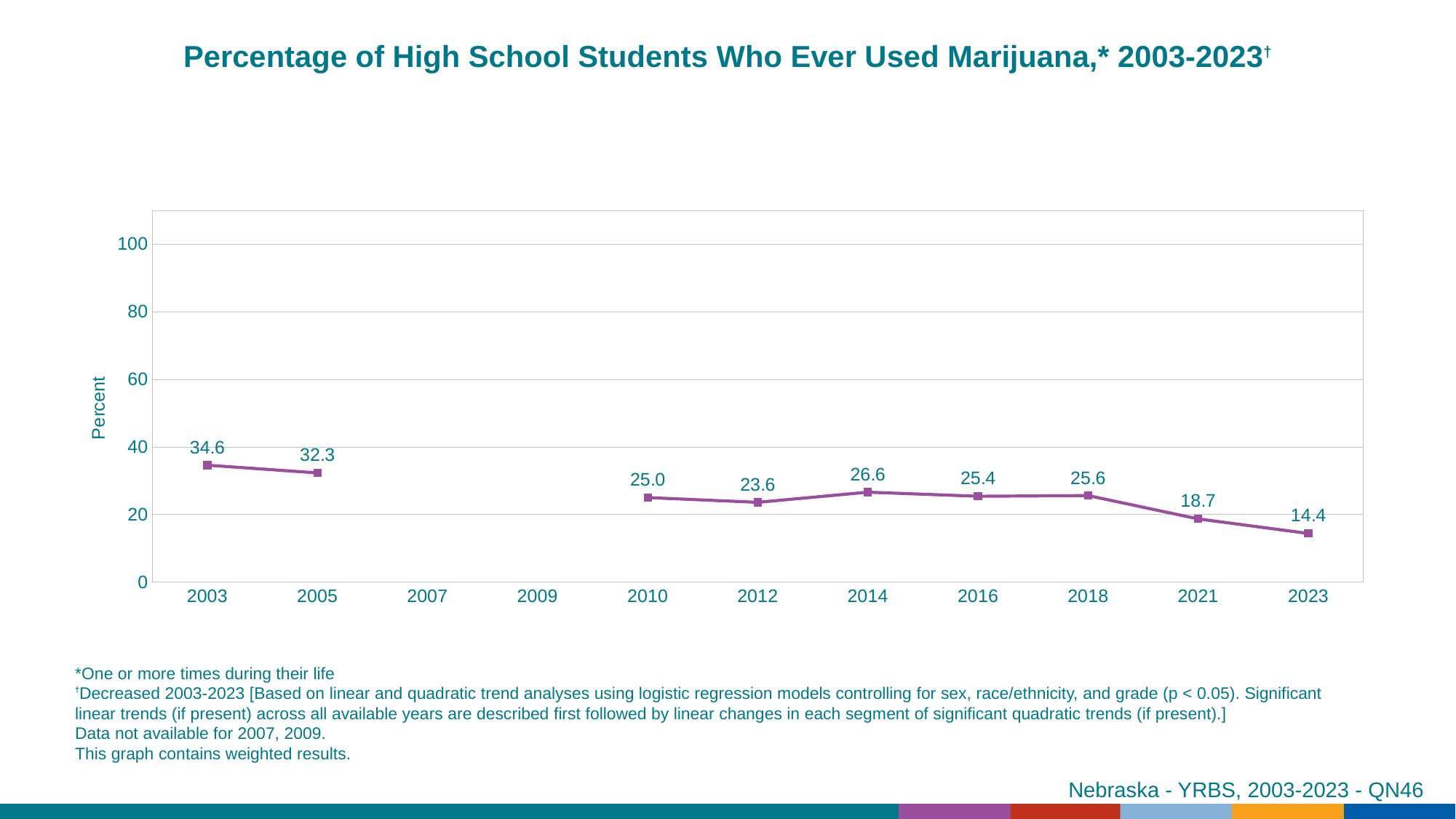
Which is larger, the value for 2012 or the value for 2014? 2014 Which year has the lowest value on the chart? 2023 What percentage of high school students had ever used marijuana in 2003? 34.6 How many data points are plotted on the chart? 9 What is the value plotted for 2014? 26.6 Overall, do the values rise or fall from 2003 to 2023? fall What is the difference between the 2003 value and the 2023 value? 20.2 What kind of chart is shown on the slide? line chart Is the value for 2021 greater or less than 20? less What is the value plotted for 2023? 14.4 Which year has the highest value on the chart? 2003 For which years is data not available according to the slide? 2007, 2009